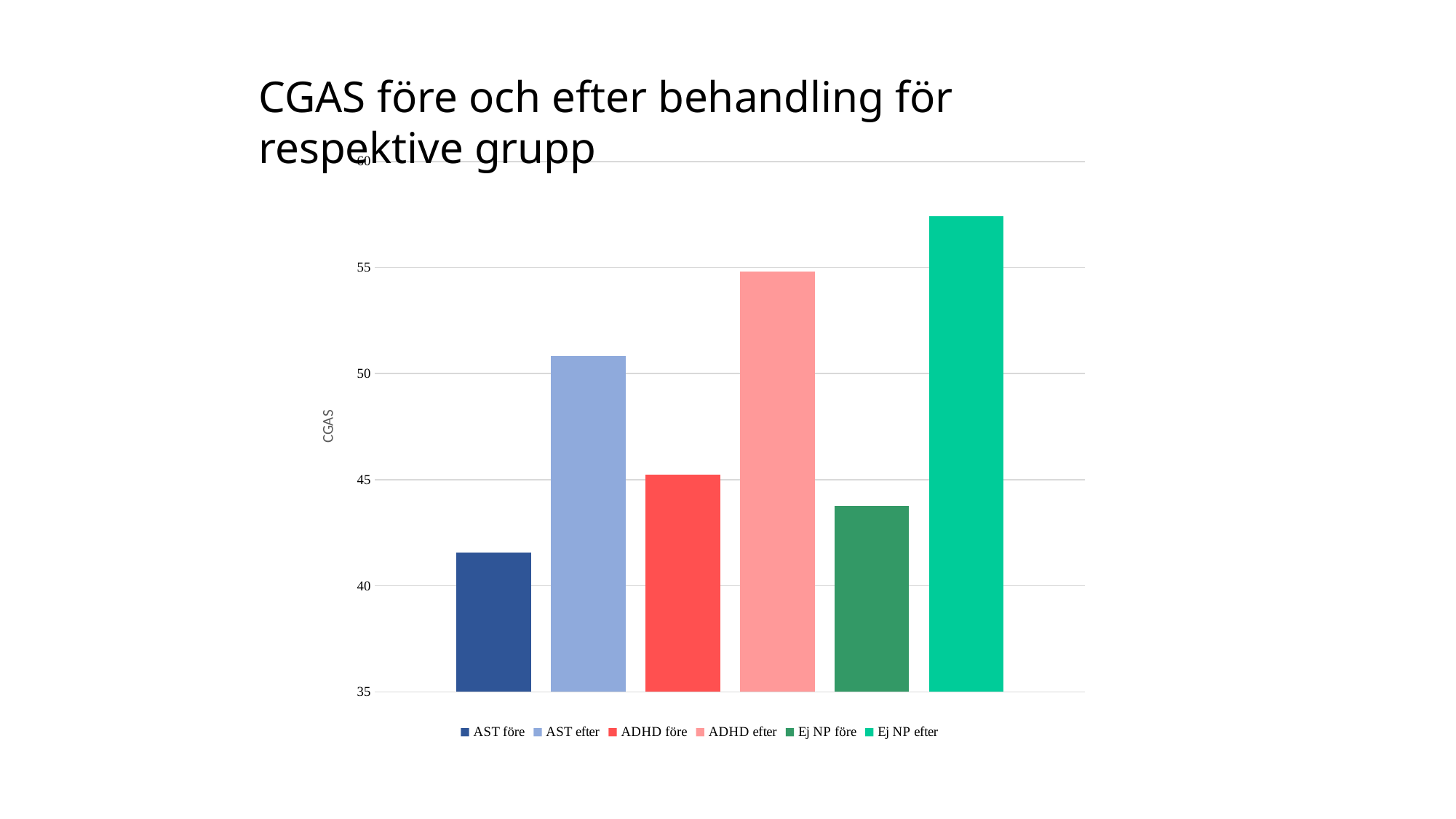
Is the value for Ej NP efter greater or less than 55? greater What kind of chart is shown on the slide? bar chart Is the value for Ej NP före greater or less than 45? less Is the value for AST efter greater or less than 50? greater What is the label on the vertical axis? CGAS Which series has the lowest CGAS value? AST före Which series has the highest CGAS value? Ej NP efter How many series does the legend list? 6 Which is larger, the value for ADHD efter or the value for Ej NP efter? Ej NP efter Which is larger, the value for AST efter or the value for ADHD före? AST efter What is the title of the chart? CGAS före och efter behandling för respektive grupp